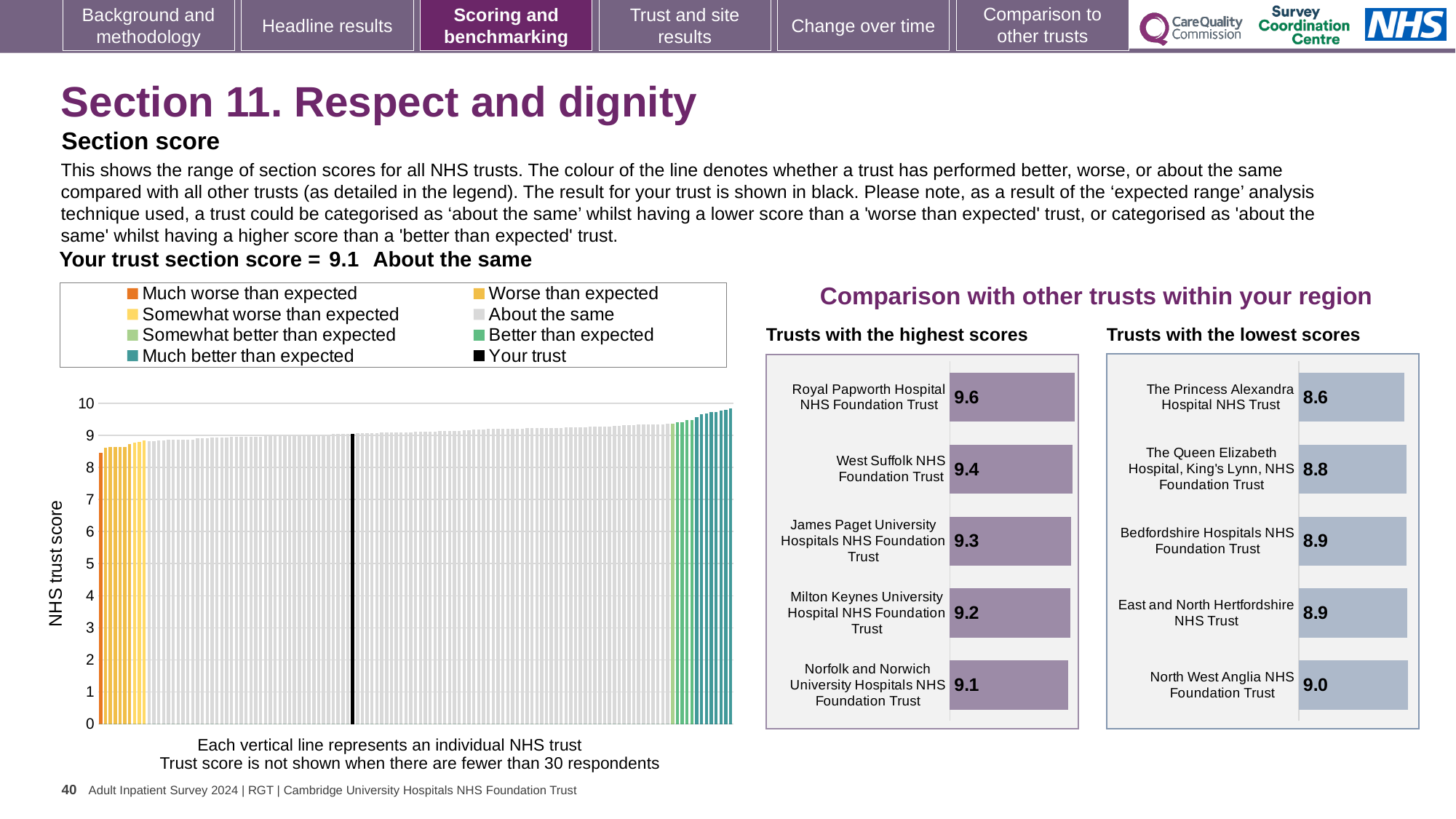
In the 'Trusts with the lowest scores' chart, which trust has the highest score? North West Anglia NHS Foundation Trust In the NHS trust score chart on the left, do the values rise or fall from left to right? Rise In the 'Trusts with the lowest scores' chart, which has the higher score: The Queen Elizabeth Hospital, King's Lynn, NHS Foundation Trust or Bedfordshire Hospitals NHS Foundation Trust? Bedfordshire Hospitals NHS Foundation Trust How many entries does the legend of the NHS trust score chart on the left list? 8 In the NHS trust score chart on the left, is the value of the lowest bar greater or less than 8? greater In the 'Trusts with the highest scores' chart, what is the score for Milton Keynes University Hospital NHS Foundation Trust? 9.2 In the 'Trusts with the lowest scores' chart, what is the score for The Princess Alexandra Hospital NHS Trust? 8.6 In the 'Trusts with the highest scores' chart, which trust has the lowest score? Norfolk and Norwich University Hospitals NHS Foundation Trust In the 'Trusts with the highest scores' chart, what is the score for Royal Papworth Hospital NHS Foundation Trust? 9.6 What kind of chart is the NHS trust score chart on the left of the slide? Bar chart In the 'Trusts with the highest scores' chart, what is the difference between the scores of Royal Papworth Hospital NHS Foundation Trust and Norfolk and Norwich University Hospitals NHS Foundation Trust? 0.5 How many trusts are shown in the 'Trusts with the lowest scores' chart? 5